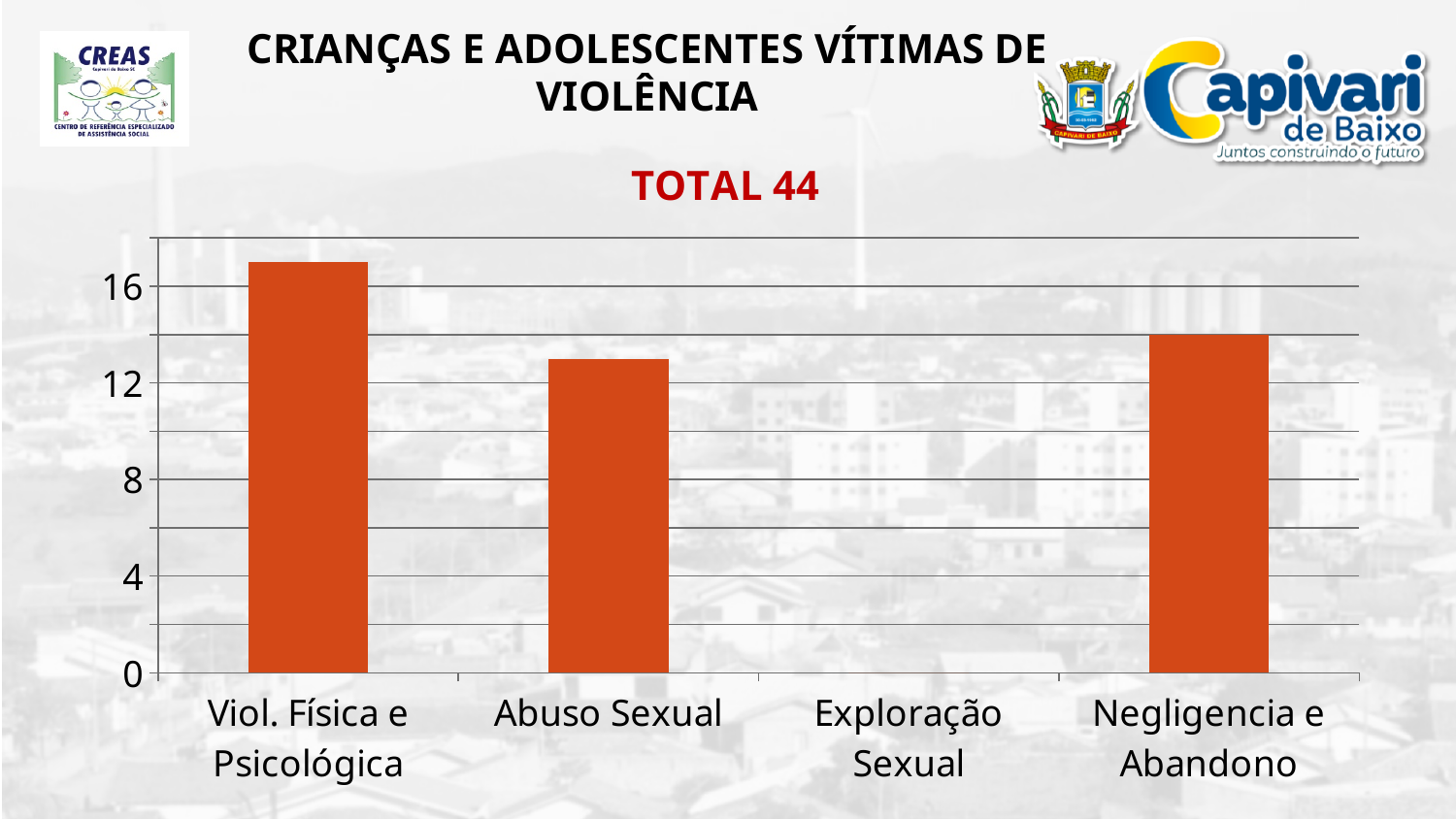
Which category has the lowest value in the chart? Exploração Sexual Is the value for Exploração Sexual greater or less than 4? less Which category has the highest bar? Viol. Física e Psicológica Which is larger, the value for Negligencia e Abandono or the value for Viol. Física e Psicológica? Viol. Física e Psicológica How many categories are shown on the x axis of the chart? 4 Which is larger, the value for Viol. Física e Psicológica or the value for Abuso Sexual? Viol. Física e Psicológica What total is stated above the chart? TOTAL 44 Is the value for Abuso Sexual greater or less than 12? greater What kind of chart is shown on the slide? bar chart Is the value for Viol. Física e Psicológica greater or less than 16? greater What is the title of the slide containing the chart? CRIANÇAS E ADOLESCENTES VÍTIMAS DE VIOLÊNCIA